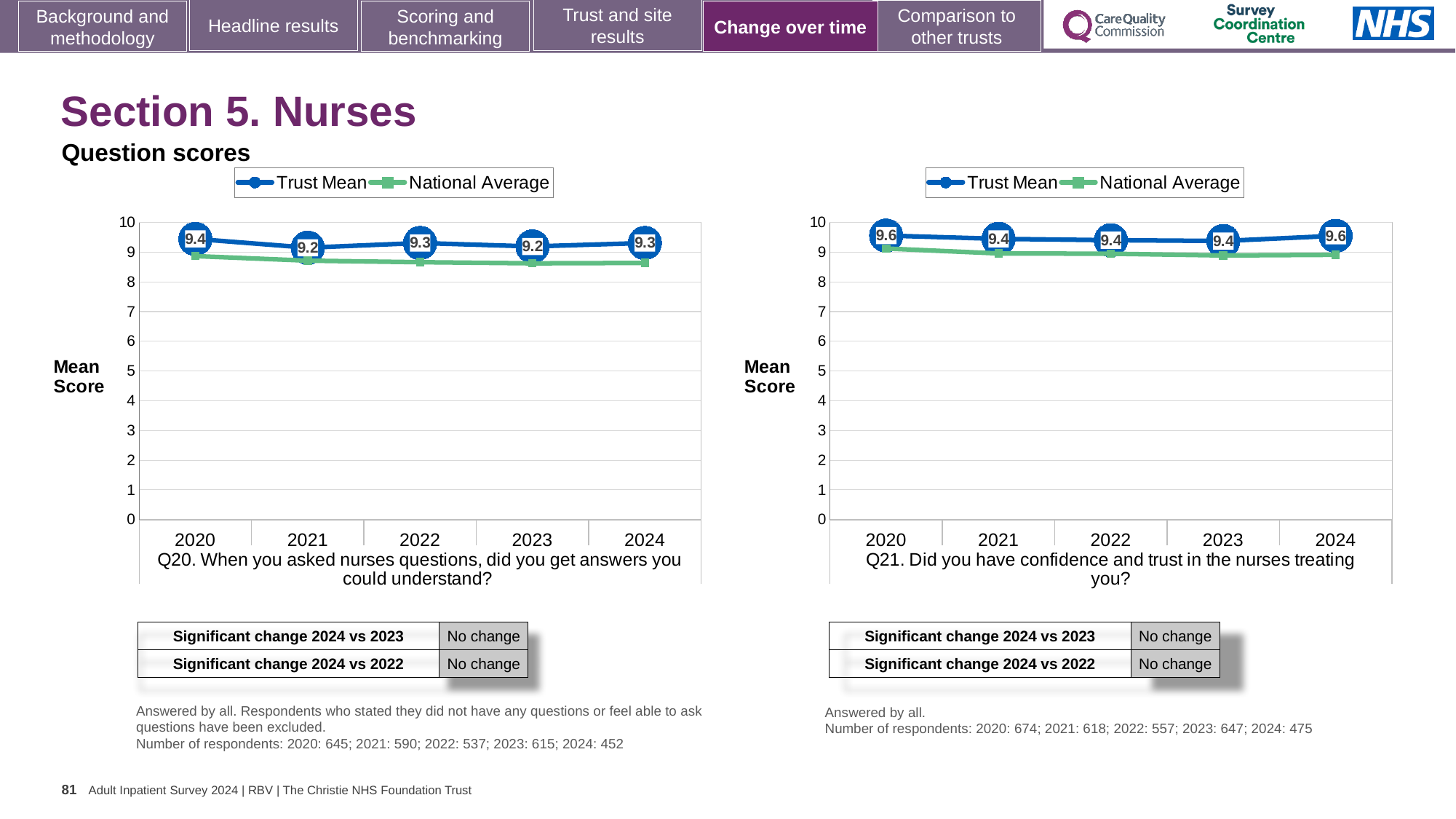
On the Q21 chart (right), what is the Trust Mean score for 2022? 9.4 On the Q21 chart (right), which years have the highest Trust Mean score? 2020 and 2024 On the Q20 chart (left), what is the Trust Mean score for 2023? 9.2 On the Q21 chart (right), what is the Trust Mean score for 2024? 9.6 On the Q20 chart (left), which year has the lowest Trust Mean score? 2021 and 2023 On the Q21 chart (right), is the Trust Mean in 2024 larger or smaller than in 2023? larger How many series does the legend of the Q20 chart (left) list? 2 What type of chart is the Q21 chart (right)? line chart How many years are plotted on the Q21 chart (right)? 5 On the Q20 chart (left), what is the Trust Mean score for 2020? 9.4 On the Q20 chart (left), is the National Average for 2024 greater or less than 9? less On the Q20 chart (left), what is the difference between the Trust Mean in 2020 and in 2021? 0.2